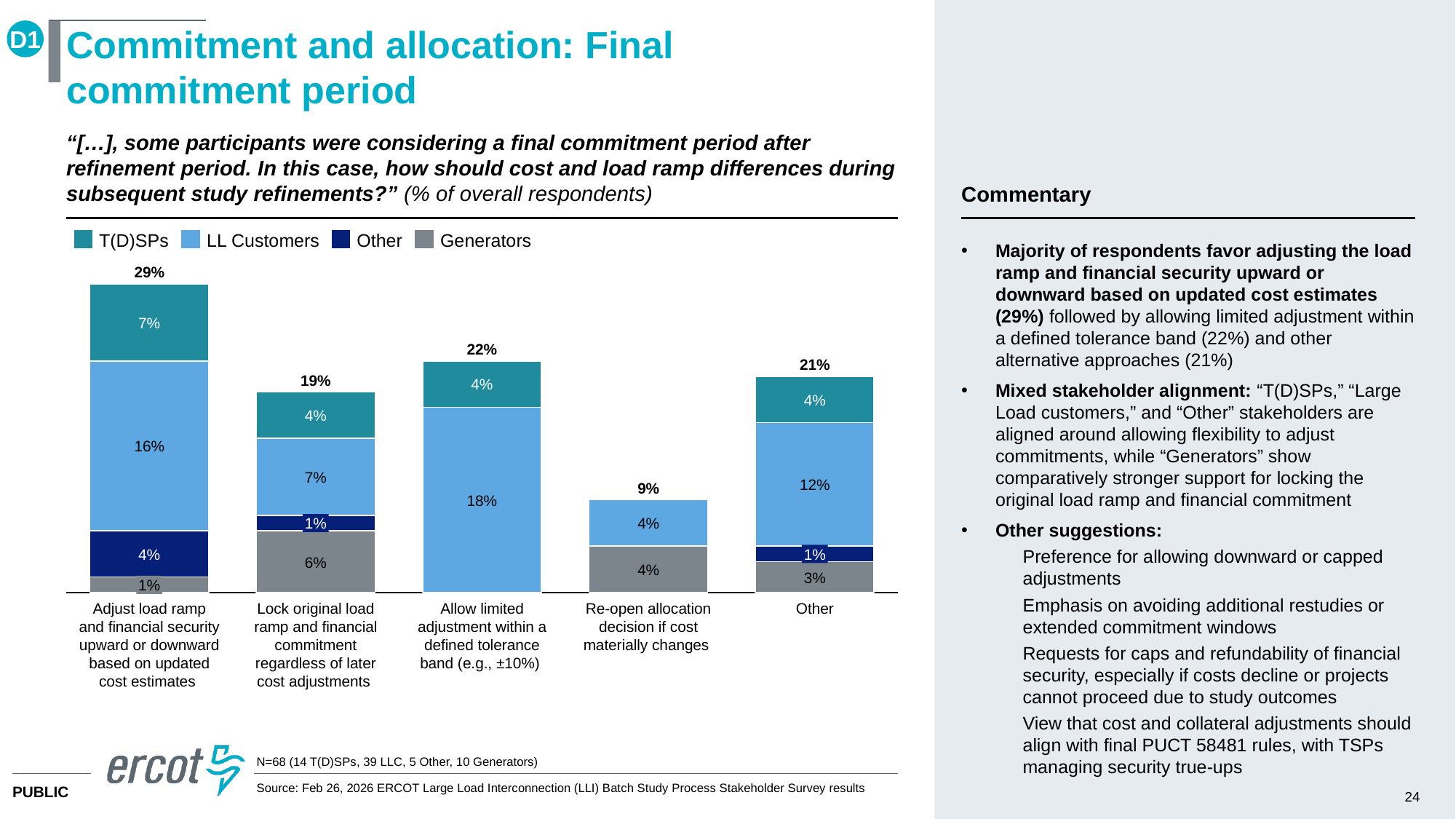
What is the T(D)SPs value for the "Other" category? 4% What is the total percentage for "Adjust load ramp and financial security upward or downward based on updated cost estimates"? 29% Which category has the highest total percentage? Adjust load ramp and financial security upward or downward based on updated cost estimates How many series does the chart legend list? 4 How many categories are shown on the x axis of the chart? 5 What is the LL Customers value for "Allow limited adjustment within a defined tolerance band (e.g., ±10%)"? 18% Which is larger: the LL Customers value for "Adjust load ramp and financial security upward or downward" or the LL Customers value for "Other"? Adjust load ramp and financial security upward or downward Which series is shown in the darkest blue colour in the legend? Other What is the Generators value for "Lock original load ramp and financial commitment regardless of later cost adjustments"? 6% Which category has the lowest total percentage? Re-open allocation decision if cost materially changes What kind of chart is shown on the slide? Stacked bar chart What is the difference between the total for "Allow limited adjustment within a defined tolerance band" and the total for "Lock original load ramp and financial commitment"? 3%